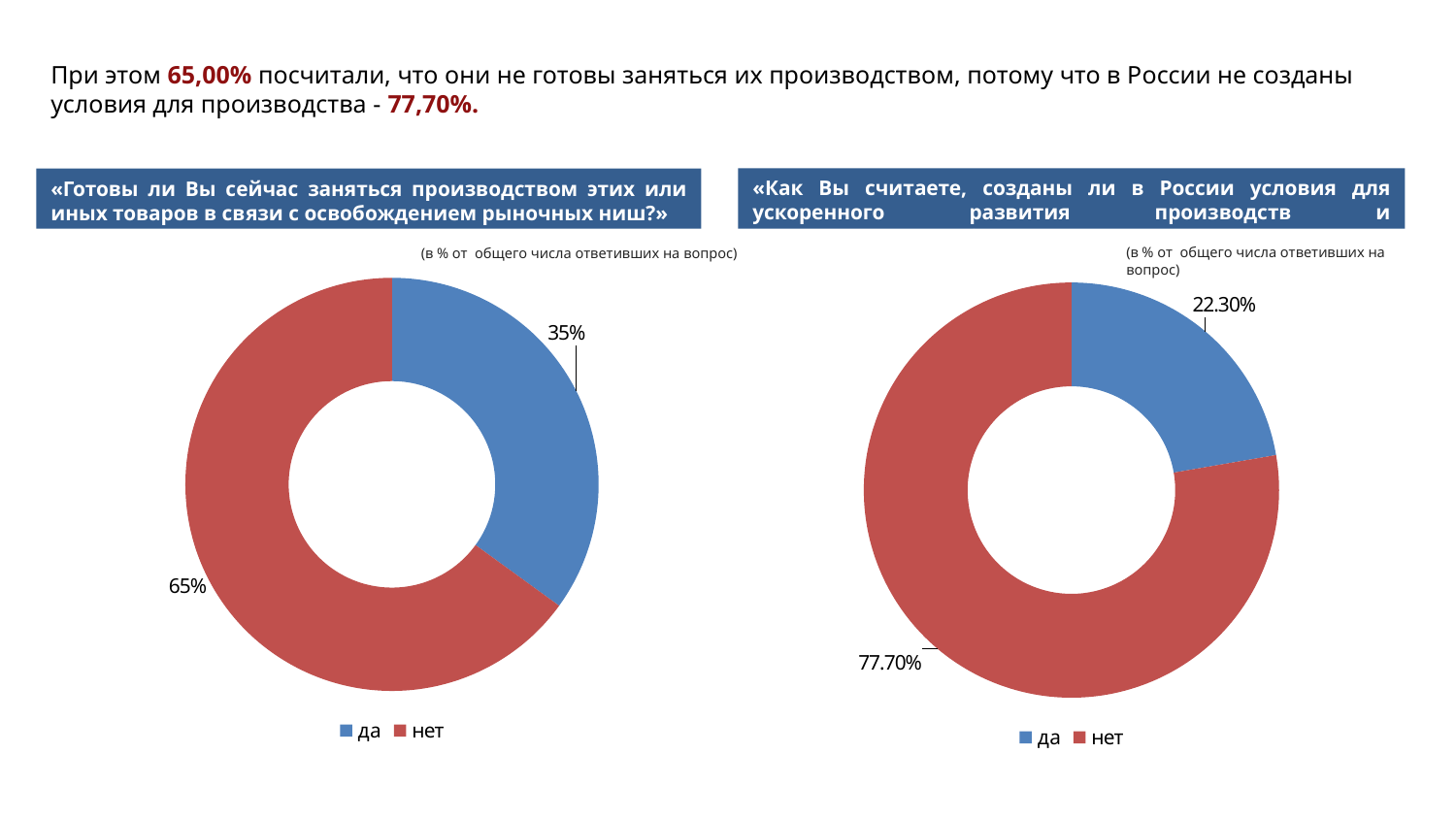
How many categories does the legend of the right chart list? 2 In the left chart («Готовы ли Вы сейчас заняться производством...»), what share of respondents answered «нет»? 65% What type of chart is used on the left side of the slide? Doughnut (pie) chart In the right chart, what is the difference in percentage points between «нет» and «да»? 55.40 In the right chart, which colour represents the answer «нет»? Red Which chart shows a larger share for «да», the left chart or the right chart? The left chart In the left chart («Готовы ли Вы сейчас заняться производством...»), what share of respondents answered «да»? 35% In the right chart, which answer has the smallest share? да In the right chart («Как Вы считаете, созданы ли в России условия...»), what share of respondents answered «да»? 22.30% In the left chart, which answer has the larger share, «да» or «нет»? нет In the left chart, what is the difference in percentage points between «нет» and «да»? 30 In the right chart («Как Вы считаете, созданы ли в России условия...»), what share of respondents answered «нет»? 77.70%